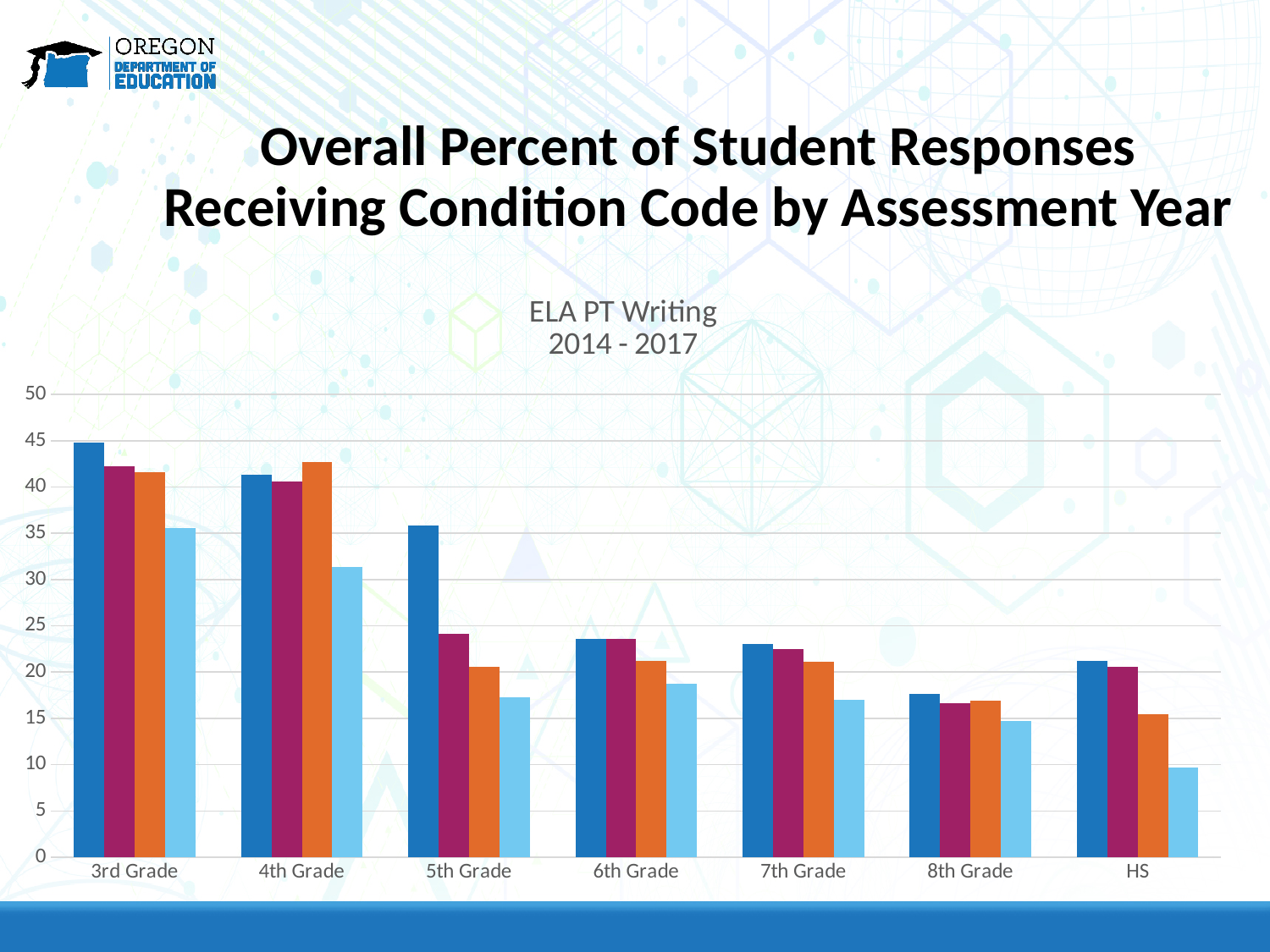
Is the dark blue bar for 5th Grade greater or less than 30? greater How many grade categories are shown on the x axis of the chart? 7 Which grade has the tallest dark blue bar? 3rd Grade Is the dark blue bar for 3rd Grade greater or less than 40? greater Which grade has the shortest light blue bar? HS Is the light blue bar for 8th Grade greater or less than 20? less How many bars are plotted for each grade category in the chart? 4 What is the subtitle shown above the chart? ELA PT Writing 2014 - 2017 Which is larger, the dark blue bar for 3rd Grade or the dark blue bar for 4th Grade? 3rd Grade Do the dark blue bars generally rise or fall from 3rd Grade to HS? fall What kind of chart is shown on the slide? bar chart